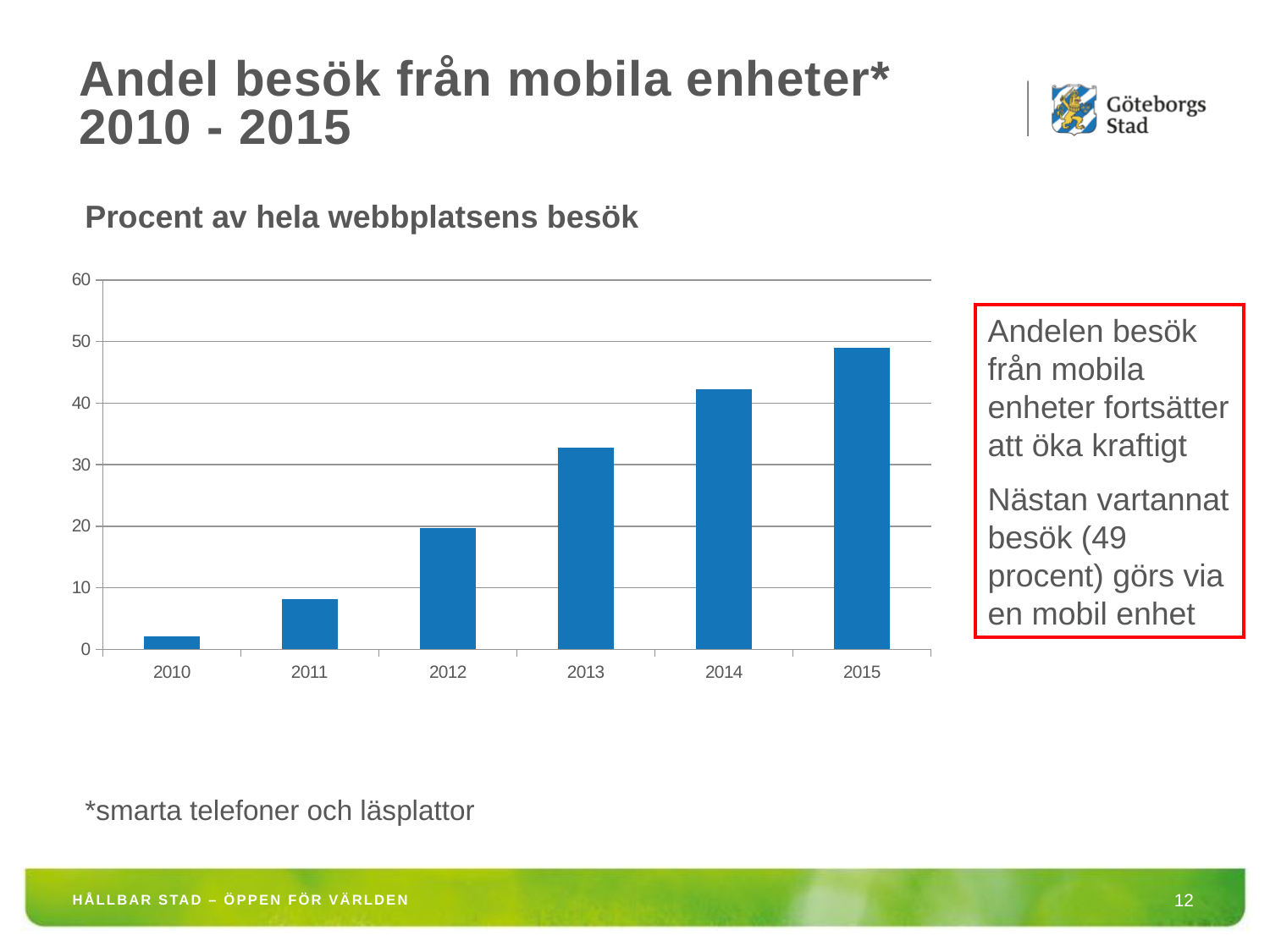
What kind of chart is shown on the slide? bar chart According to the slide, what share of visits in 2015 were made via a mobile device? 49 procent How many years are shown on the x axis of the chart? 6 Is the value for 2010 greater or less than 10? less Is the value for 2011 greater or less than 10? less Which year has the lowest share of visits from mobile devices? 2010 Is the value for 2013 greater or less than 30? greater Which year has the highest share of visits from mobile devices? 2015 Do the values rise or fall from 2010 to 2015? rise Which is larger, the value for 2014 or the value for 2012? 2014 What is the title of the slide containing the chart? Andel besök från mobila enheter* 2010 - 2015